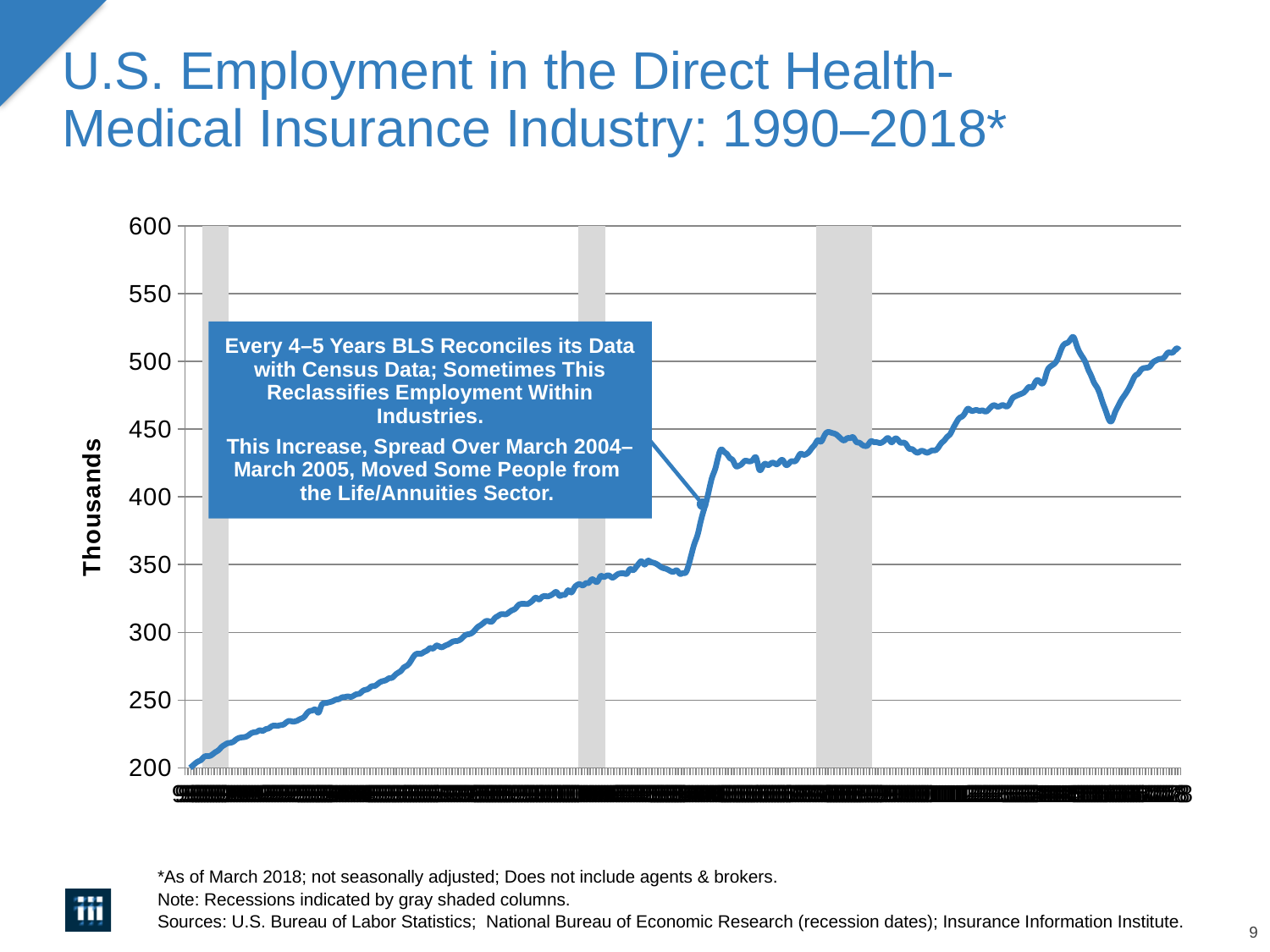
What is the highest value shown on the vertical axis? 600 Is the value at the dip in the line after the third gray shaded column greater or less than 400? greater How many gray shaded recession columns are shown on the chart? 3 Is the highest point of the line greater or less than 500? greater What is the label on the vertical axis of the chart? Thousands What is the title of the chart on the slide? U.S. Employment in the Direct Health-Medical Insurance Industry: 1990–2018* Is the lowest point of the line greater or less than 250? less What kind of chart is shown on the slide? line chart Do the values in the chart generally rise or fall from left to right? rise